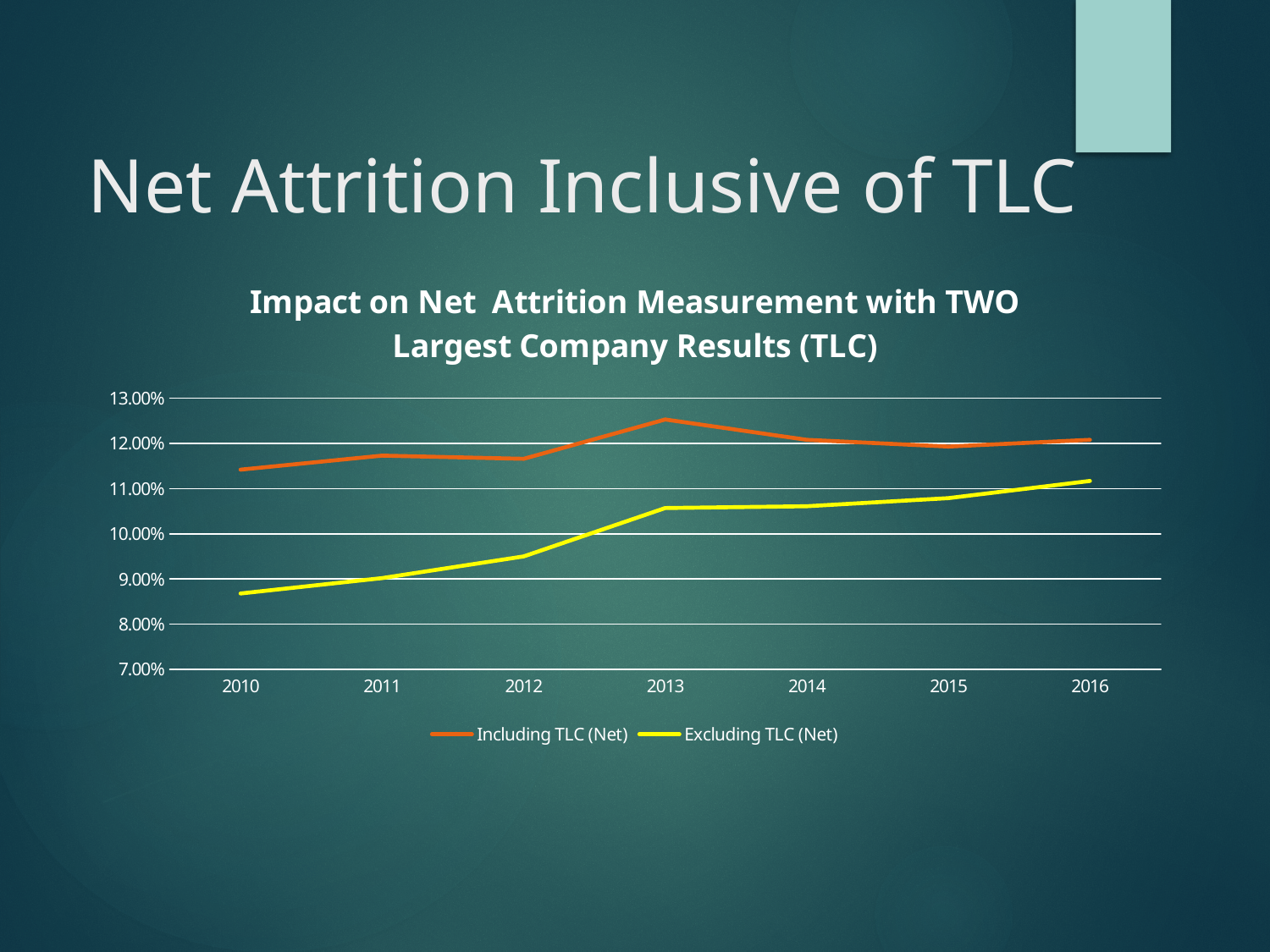
Is the value for Excluding TLC (Net) in 2016 greater or less than 11.00%? greater Is the value for Excluding TLC (Net) in 2010 greater or less than 9.00%? less Is the value for Including TLC (Net) in 2013 greater or less than 12.00%? greater How many series does the legend list? 2 What kind of chart is shown on the slide? line chart In which year does the Including TLC (Net) line reach its highest value? 2013 In which year is the Excluding TLC (Net) value lowest? 2010 What colour is the line for Excluding TLC (Net)? yellow Does the Excluding TLC (Net) line generally rise or fall from 2010 to 2016? rise Which series has the higher value in 2014, Including TLC (Net) or Excluding TLC (Net)? Including TLC (Net) How many years are plotted along the x axis? 7